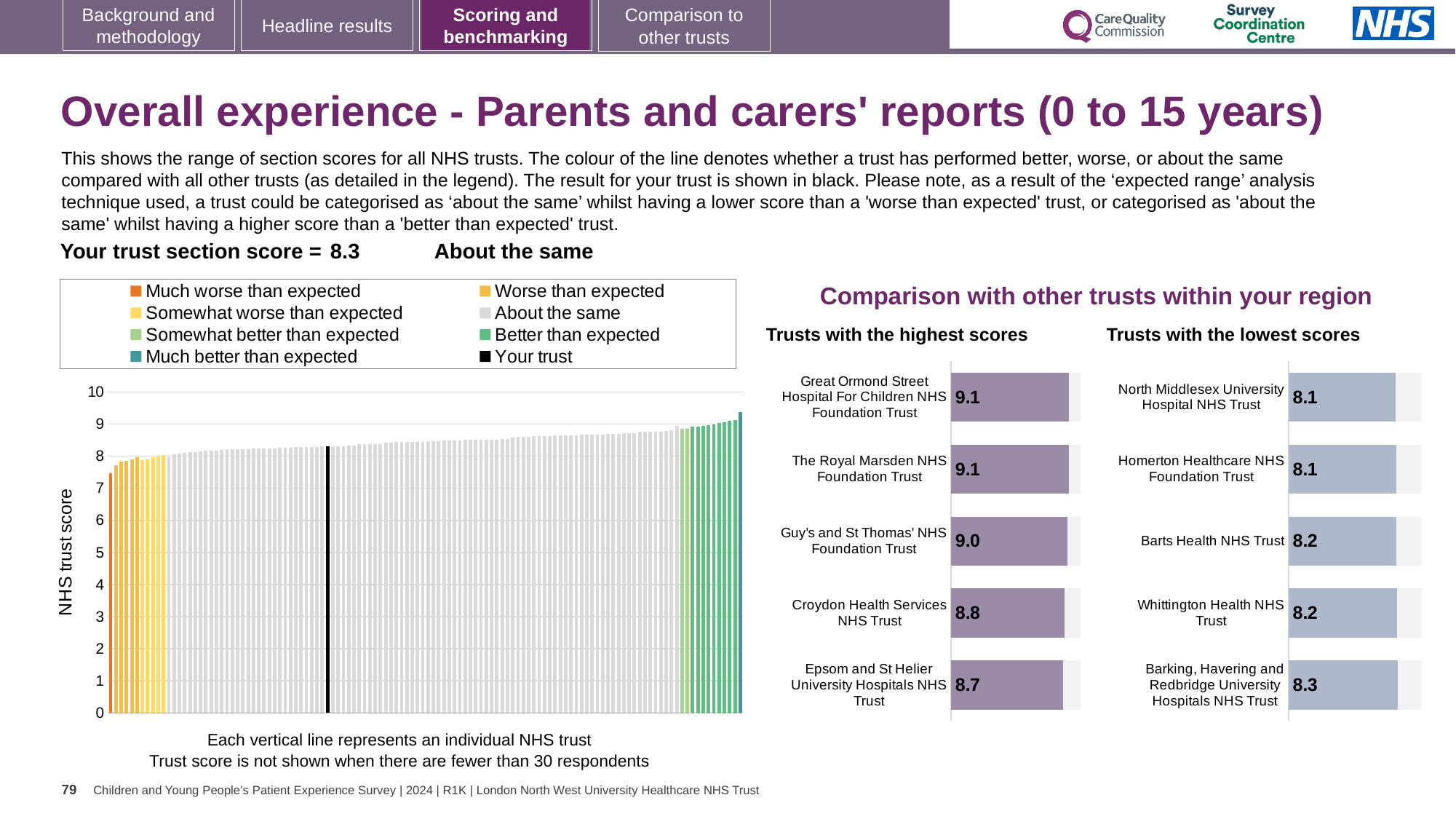
In the 'Trusts with the highest scores' chart, what is the score for Great Ormond Street Hospital For Children NHS Foundation Trust? 9.1 In the 'Trusts with the highest scores' chart, which has the higher score: Guy's and St Thomas' NHS Foundation Trust or Croydon Health Services NHS Trust? Guy's and St Thomas' NHS Foundation Trust What kind of chart is the large chart on the left showing NHS trust scores? Bar chart In the 'Trusts with the highest scores' chart, what is the score for Croydon Health Services NHS Trust? 8.8 In the 'Trusts with the lowest scores' chart, what is the score for Barts Health NHS Trust? 8.2 In the 'Trusts with the highest scores' chart, which trust has the lowest score? Epsom and St Helier University Hospitals NHS Trust In the 'Trusts with the highest scores' chart, what is the difference between the scores of Great Ormond Street Hospital For Children NHS Foundation Trust and Epsom and St Helier University Hospitals NHS Trust? 0.4 In the large NHS trust score chart on the left, is the value of the lowest (orange) bar greater or less than 8? less In the 'Trusts with the lowest scores' chart, what is the difference between the scores of Barking, Havering and Redbridge University Hospitals NHS Trust and North Middlesex University Hospital NHS Trust? 0.2 In the 'Trusts with the lowest scores' chart, which trust has the highest score? Barking, Havering and Redbridge University Hospitals NHS Trust How many trusts are shown in the 'Trusts with the lowest scores' chart? 5 How many entries does the legend of the large NHS trust score chart list? 8